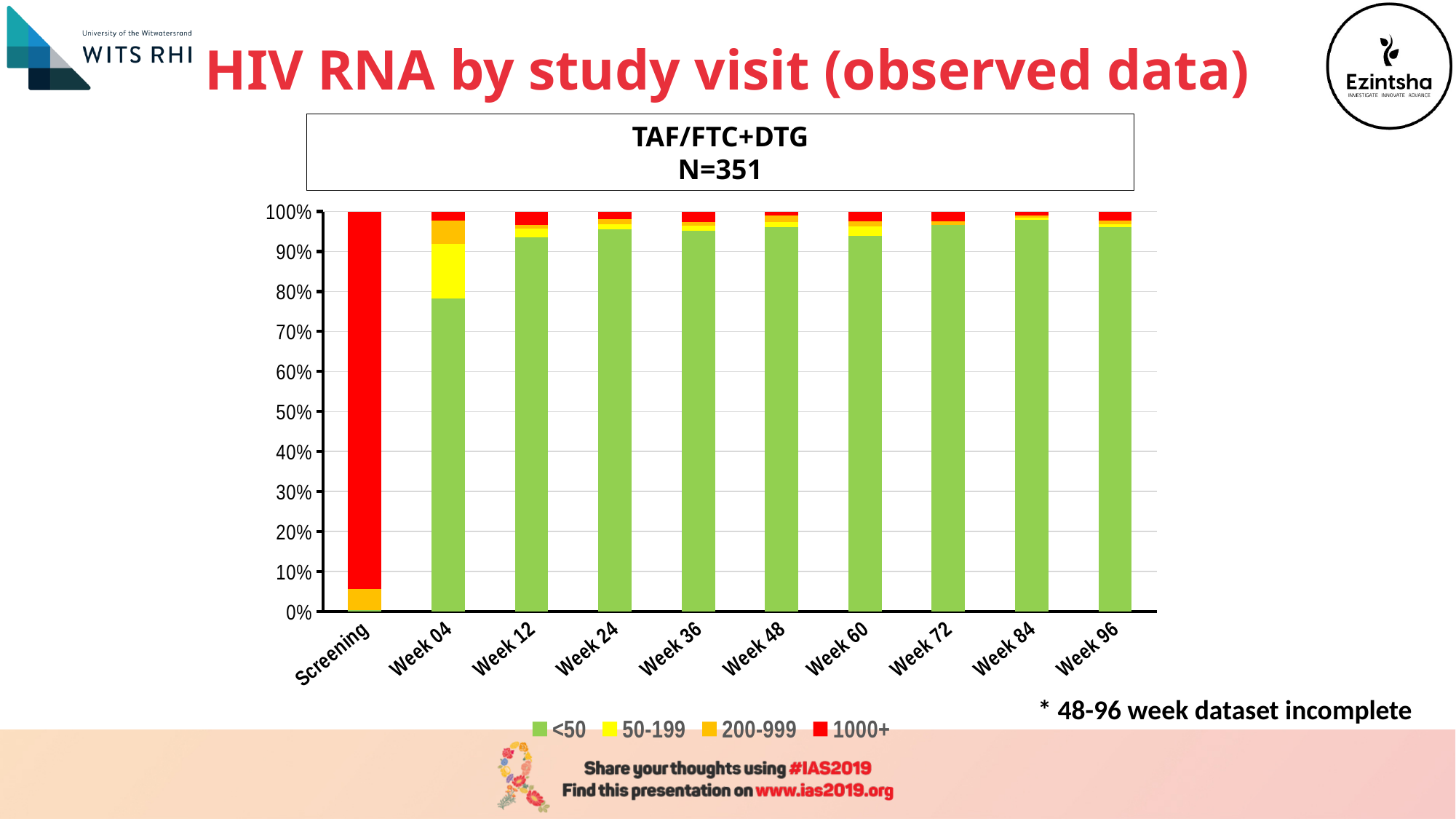
Among the Week visits, which has the smallest <50 share? Week 04 How many study visits are shown on the x axis? 10 What is the total of the stacked bar for Week 24? 100% Which HIV RNA category makes up almost the entire Screening bar? 1000+ What is the N shown in the box above the chart? N=351 Is the <50 share at Week 04 greater or less than 70%? greater Is the 1000+ share at Screening greater or less than 90%? greater Does the <50 share rise or fall from Week 04 to Week 12? rise How many series does the legend list? 4 What kind of chart is shown on the slide? stacked bar chart Is the <50 share at Week 12 greater or less than 90%? greater Which is larger, the <50 share at Week 04 or at Week 12? Week 12